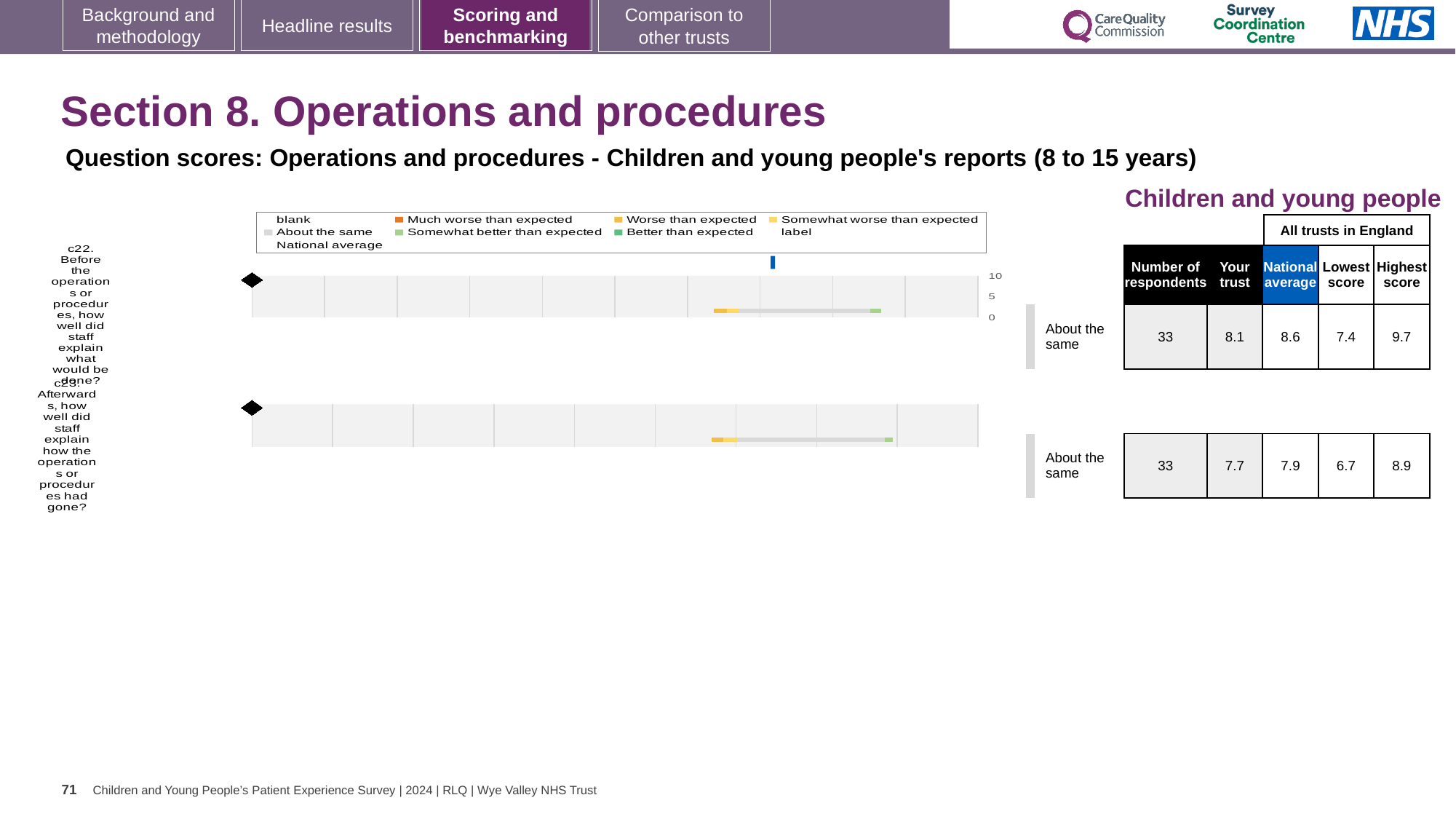
How many questions (c22 and c23) are plotted on the slide? 2 What is the 'Your trust' score for c22 (Before the operations or procedures, how well did staff explain what would be done?)? 8.1 What is the lowest score across all trusts in England for c22? 7.4 What is the highest score across all trusts in England for c23? 8.9 How many entries does the chart legend list? 9 What benchmark category is shown for c23? About the same What is the difference between the national average and the 'Your trust' score for c22? 0.5 What is the 'Your trust' score for c23 (Afterwards, how well did staff explain how the operations or procedures had gone?)? 7.7 What is the national average for c22? 8.6 How many respondents answered c23? 33 Which question has the higher 'Your trust' score, c22 or c23? c22 What kind of chart is used to show the question scores for c22 and c23? bar chart